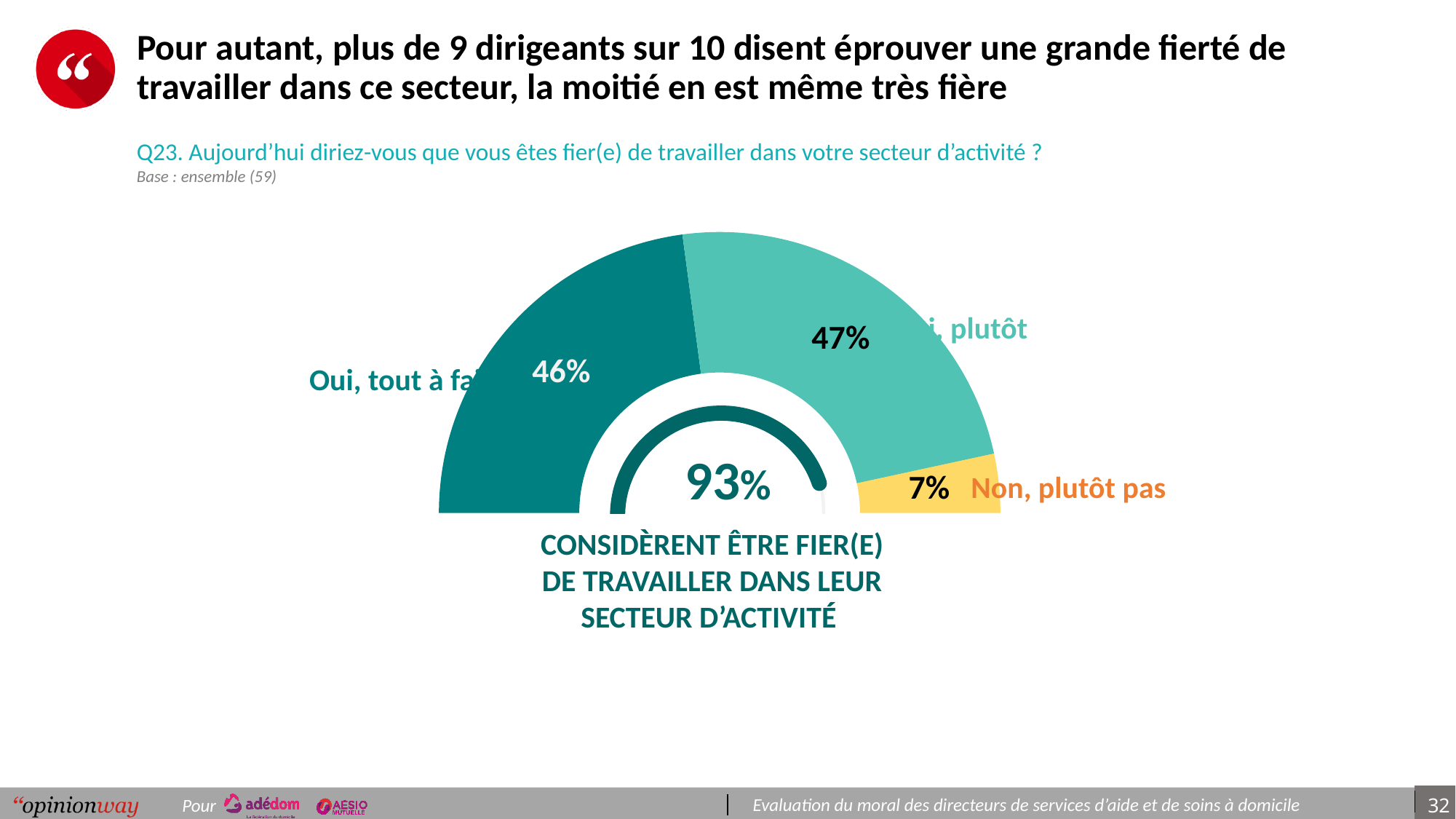
What is the combined share of the two "Oui" segments (46% and 47%)? 93% What is the difference between the "Oui, tout à fait" share and the "Non, plutôt pas" share? 39 percentage points What percentage of respondents answered "Oui, tout à fait"? 46% Which response category has the smallest share? Non, plutôt pas Which is larger: the "Oui, tout à fait" share or the "Non, plutôt pas" share? Oui, tout à fait What percentage is displayed in the centre of the chart? 93% What value is shown on the light teal segment of the chart? 47% How many segments does the chart have? 3 What kind of chart is shown on the slide? doughnut chart (half-doughnut / gauge) What percentage of respondents answered "Non, plutôt pas"? 7% What is the base (number of respondents) stated for this question? 59 What colour is the "Non, plutôt pas" segment? yellow